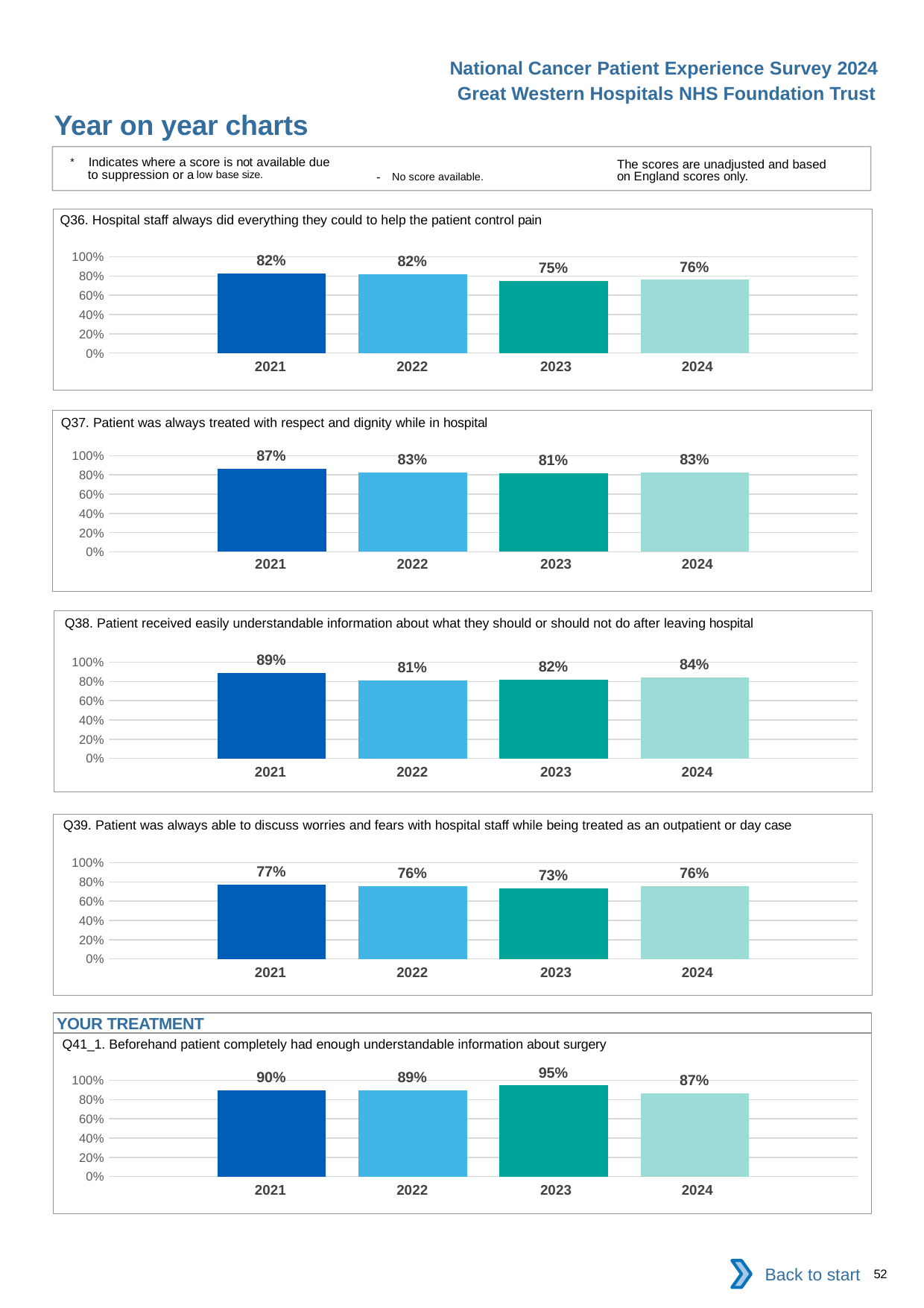
In the Q39 chart, what is the difference between the 2021 and 2023 values? 4 percentage points In the Q36 chart, what is the value for 2023? 75% In the Q38 chart, what is the difference between the 2021 and 2022 values? 8 percentage points In the Q41_1 chart, what is the value for 2023? 95% How many years are shown in the Q36 chart? 4 In the Q39 chart, which year has the lowest value? 2023 In the Q36 chart, is the value for 2024 greater or less than 80%? less In the Q41_1 chart, which is larger, the value for 2022 or the value for 2024? 2022 Which section heading appears above the Q41_1 chart? YOUR TREATMENT What type of chart is the Q37 chart? Bar chart In the Q37 chart, which year has the highest value? 2021 In the Q38 chart, what is the value for 2024? 84%